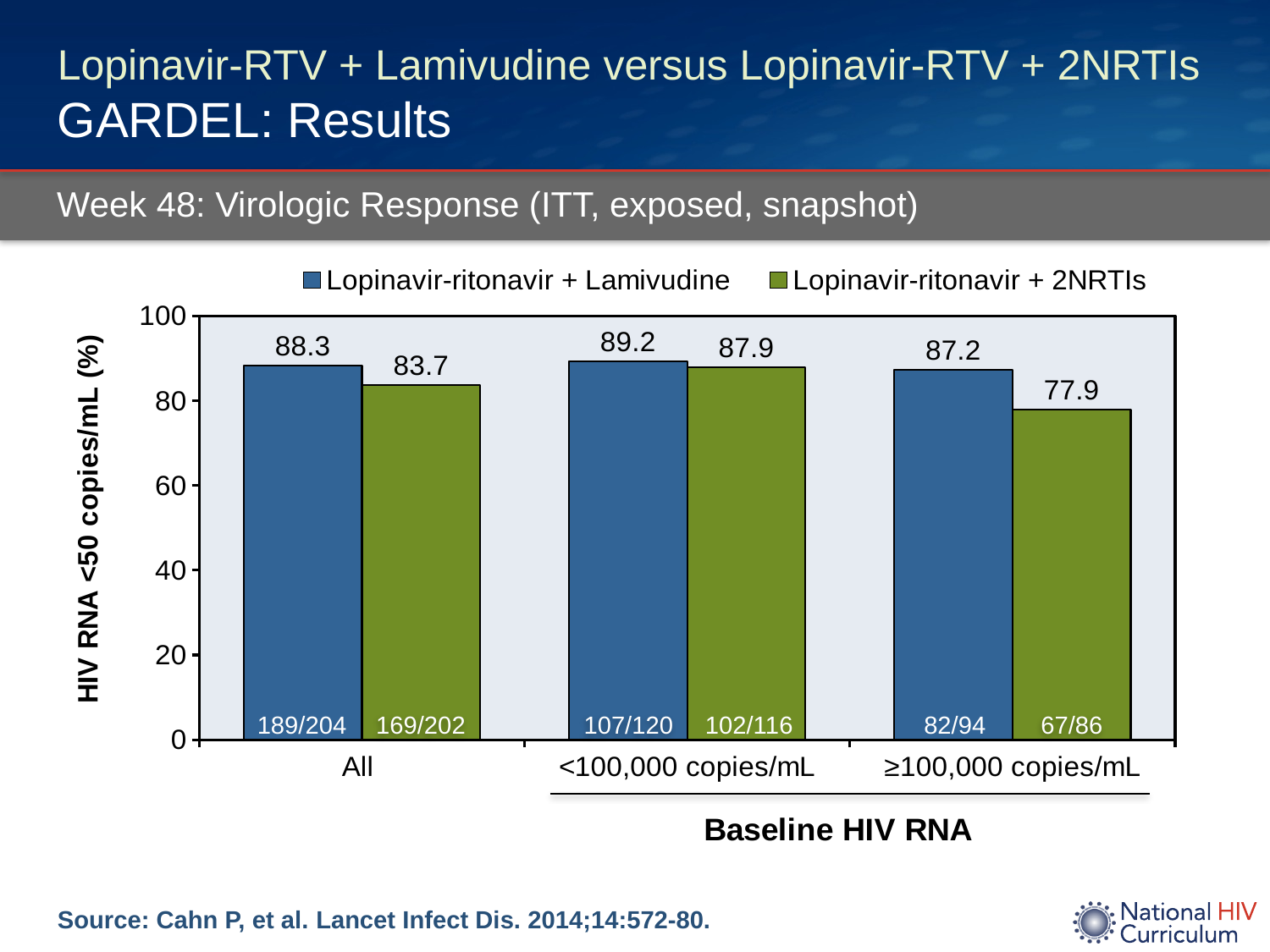
How many categories are shown on the x axis? 3 In the <100,000 copies/mL group, which series has the larger value? Lopinavir-ritonavir + Lamivudine What is the value for Lopinavir-ritonavir + Lamivudine in the All group? 88.3 What is the difference between the two series in the ≥100,000 copies/mL group? 9.3 What is the value for Lopinavir-ritonavir + 2NRTIs in the ≥100,000 copies/mL group? 77.9 What is the value for Lopinavir-ritonavir + 2NRTIs in the <100,000 copies/mL group? 87.9 Which category has the lowest value for Lopinavir-ritonavir + 2NRTIs? ≥100,000 copies/mL What fraction is printed inside the Lopinavir-ritonavir + Lamivudine bar for the All group? 189/204 How many series does the legend list? 2 What is the difference between the two series in the All group? 4.6 Which category has the highest value for Lopinavir-ritonavir + Lamivudine? <100,000 copies/mL What kind of chart is shown on the slide? Bar chart